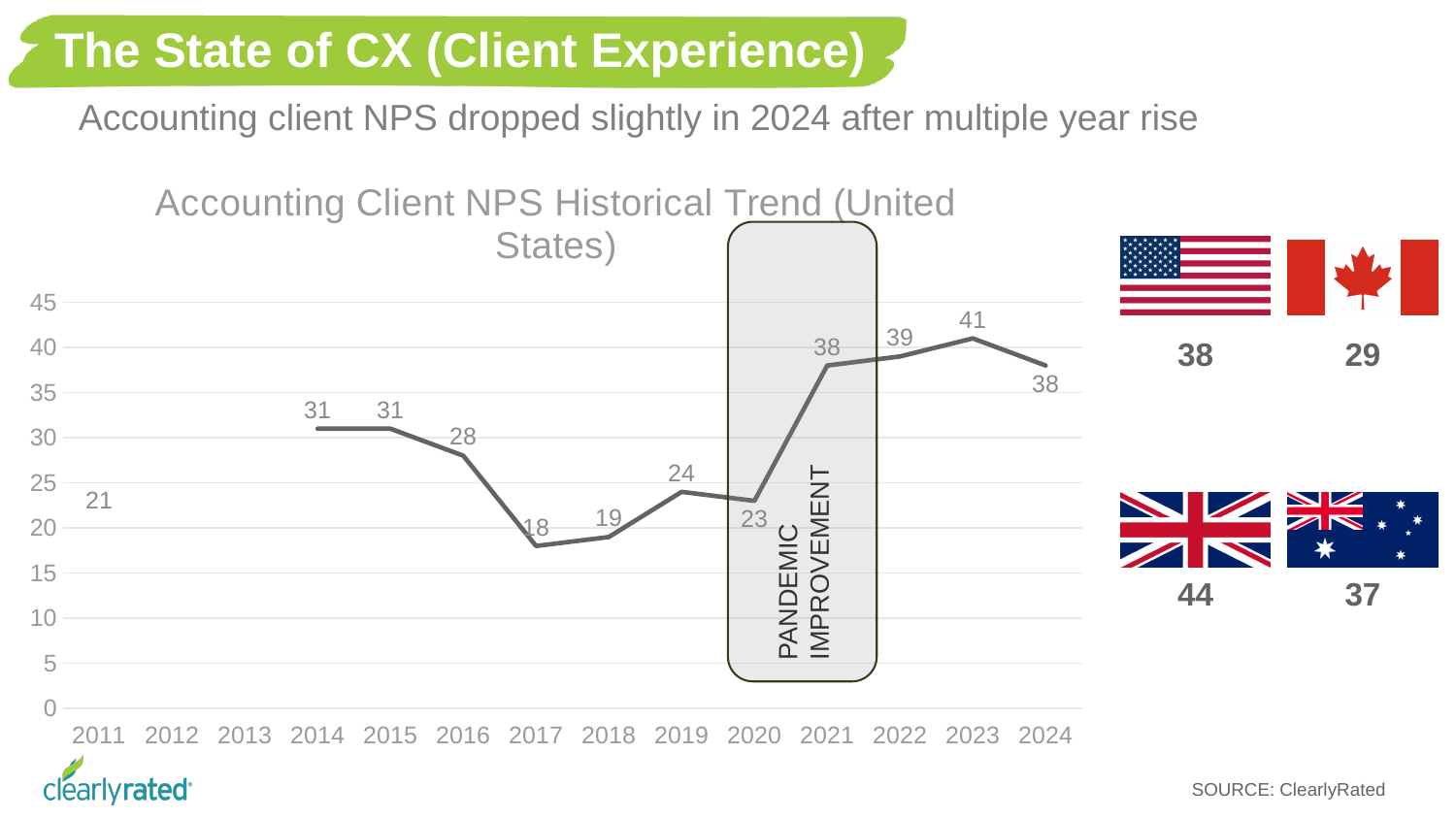
What is the difference between the NPS values for 2021 and 2020? 15 What is the NPS value for 2017? 18 Which year has a larger NPS value, 2016 or 2019? 2016 What label is written inside the shaded box on the chart? PANDEMIC IMPROVEMENT What is the NPS value for 2021? 38 What type of chart is shown on the slide? line chart What is the title of the chart? Accounting Client NPS Historical Trend (United States) Which year has the highest NPS value on the chart? 2023 Did the NPS value rise or fall from 2023 to 2024? fall How many years are shown on the x axis of the chart? 14 What is the NPS value for 2023? 41 Which year has the lowest NPS value on the chart? 2017